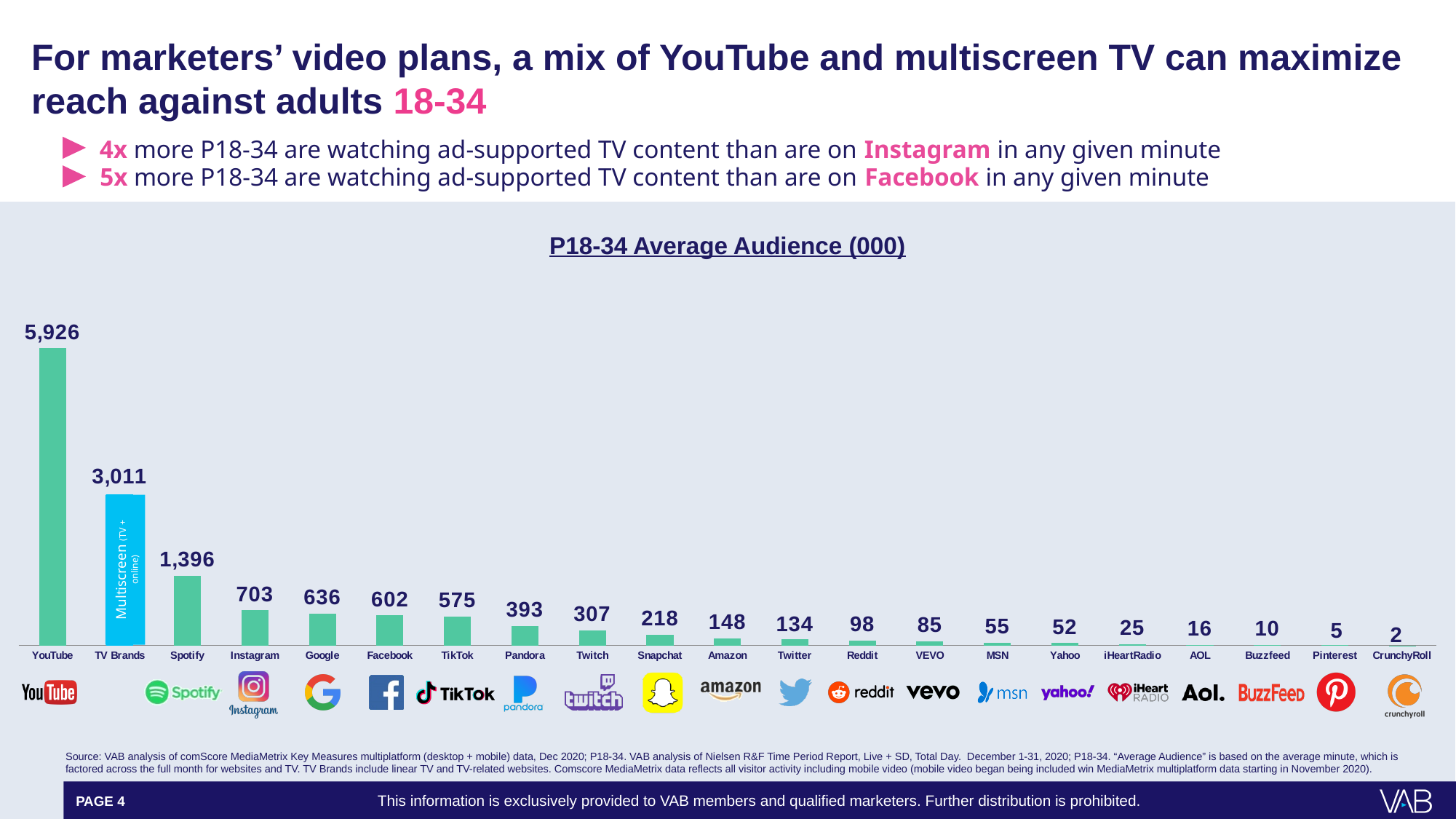
Which category has the lowest P18-34 average audience? CrunchyRoll What is the title of the chart? P18-34 Average Audience (000) What is the P18-34 average audience (000) for YouTube? 5,926 What is the value shown for Facebook? 602 Which has a larger P18-34 average audience, Spotify or Instagram? Spotify Which category has the highest P18-34 average audience? YouTube What is the value shown for TikTok? 575 What type of chart is shown on the slide? Bar chart What is the P18-34 average audience (000) for TV Brands? 3,011 How many categories are plotted in the chart? 21 What is the difference between the Instagram and Facebook values? 101 What is the difference between the YouTube and TV Brands values? 2,915